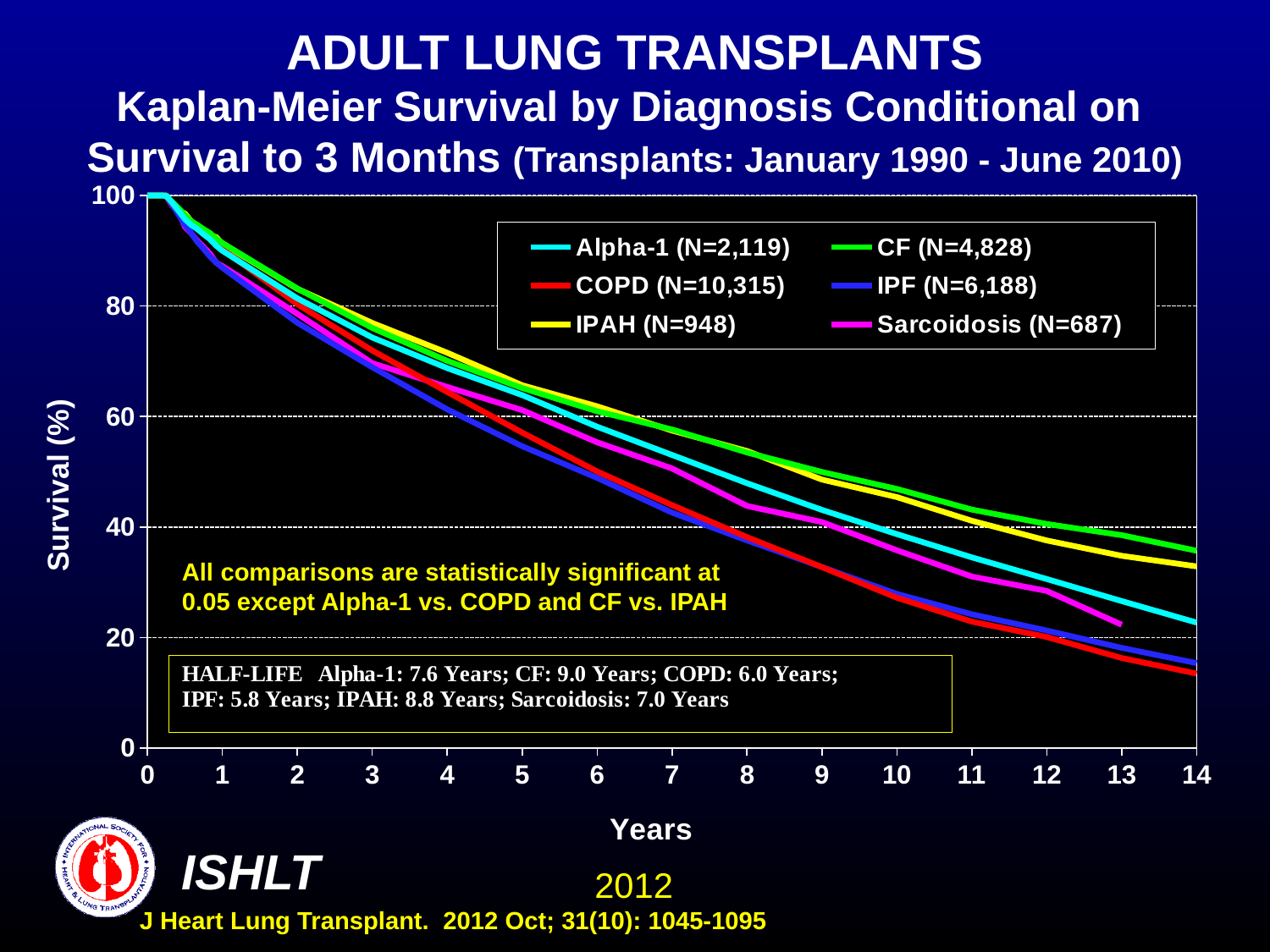
Is the survival value for IPAH at 14 years greater or less than 20? greater At 12 years, which has higher survival, IPAH or Sarcoidosis? IPAH Is the survival value for CF at 5 years greater or less than 60? greater Which diagnosis has the highest survival at 14 years? CF Which diagnosis has the lowest survival at 14 years? COPD What kind of chart is shown on the slide? line chart What is the N value shown in the legend for COPD? N=10,315 At 10 years, which has higher survival, CF or COPD? CF Is the survival value for COPD at 14 years greater or less than 20? less What is the label on the y axis? Survival (%) Do the survival curves rise or fall as years increase? fall How many series does the legend list? 6